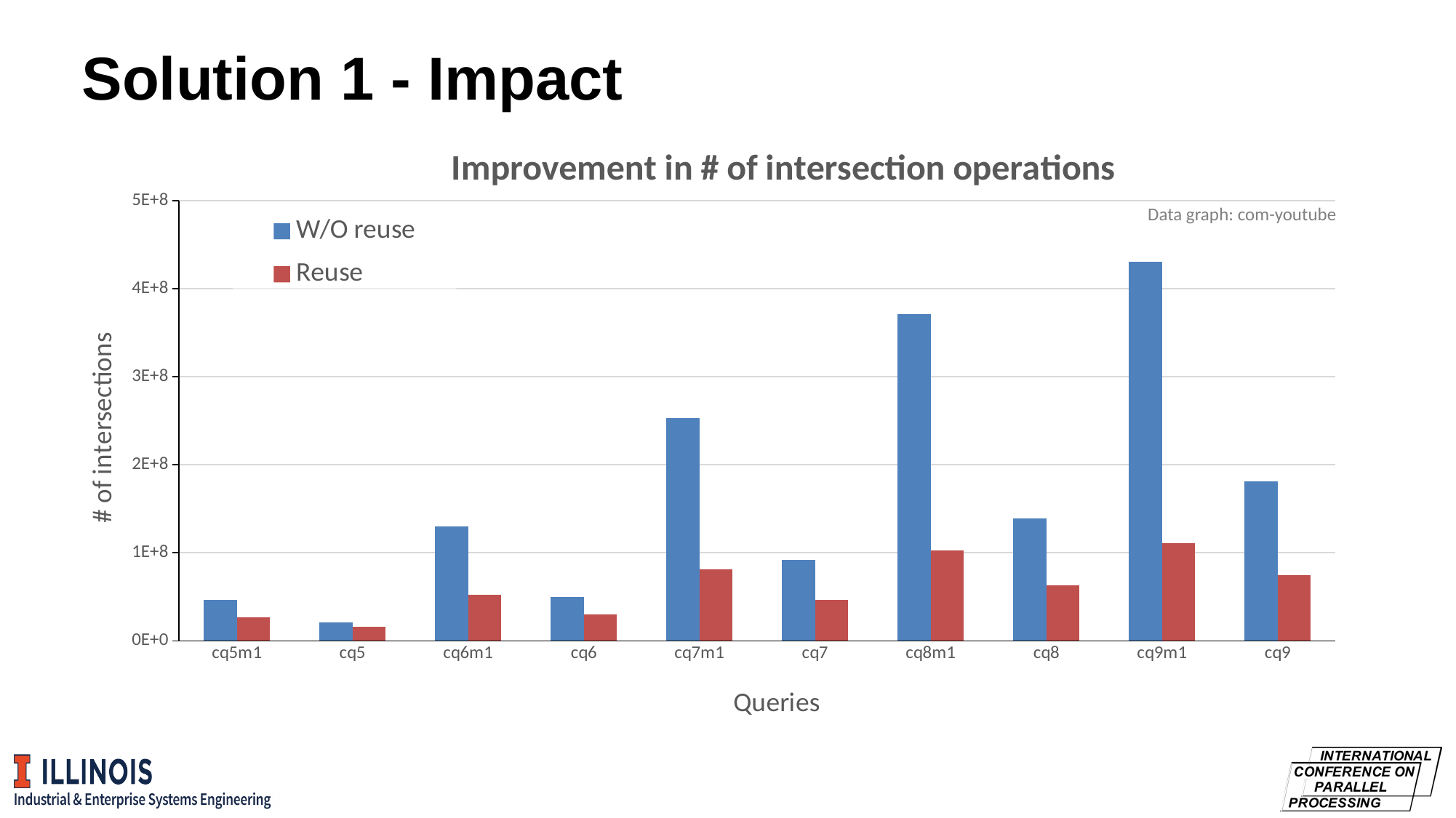
Is the W/O reuse value for cq9m1 greater or less than 4E+8? greater What kind of chart is shown on the slide? bar chart How many queries are shown on the x axis? 10 What is the title of the chart? Improvement in # of intersection operations How many series does the legend list? 2 Is the W/O reuse value for cq7 greater or less than 1E+8? less For cq8m1, which series has the larger value, W/O reuse or Reuse? W/O reuse Which query has the lowest W/O reuse value? cq5 Which query has the lowest Reuse value? cq5 Is the W/O reuse value for cq7m1 greater or less than 2E+8? greater Which query has the highest W/O reuse value? cq9m1